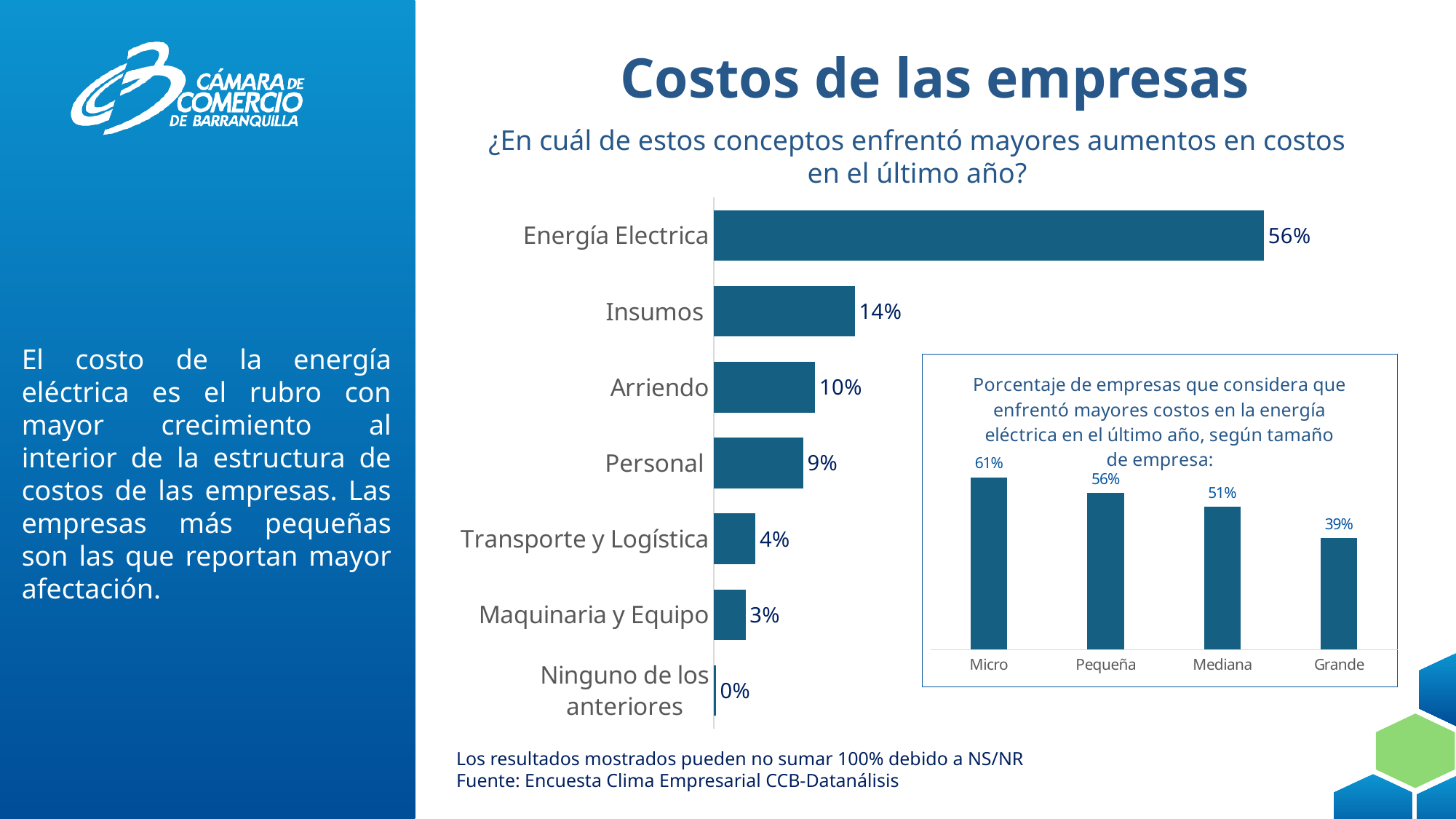
In the inset chart by company size, which category has the lowest value? Grande In the main horizontal bar chart, which category has the highest value? Energía Electrica In the main horizontal bar chart, what is the value for Insumos? 14% In the inset chart by company size, what is the difference between Micro and Grande? 22% In the main horizontal bar chart, which category has the lowest value? Ninguno de los anteriores In the inset chart by company size, what is the value for Micro? 61% In the main horizontal bar chart, what is the value for Energía Electrica? 56% What kind of chart is the main chart on the slide? Bar chart In the inset chart by company size, do the values rise or fall from Micro to Grande? Fall How many categories does the main horizontal bar chart show? 7 In the main horizontal bar chart, what is the difference between Energía Electrica and Insumos? 42% In the main horizontal bar chart, which is larger, Arriendo or Personal? Arriendo